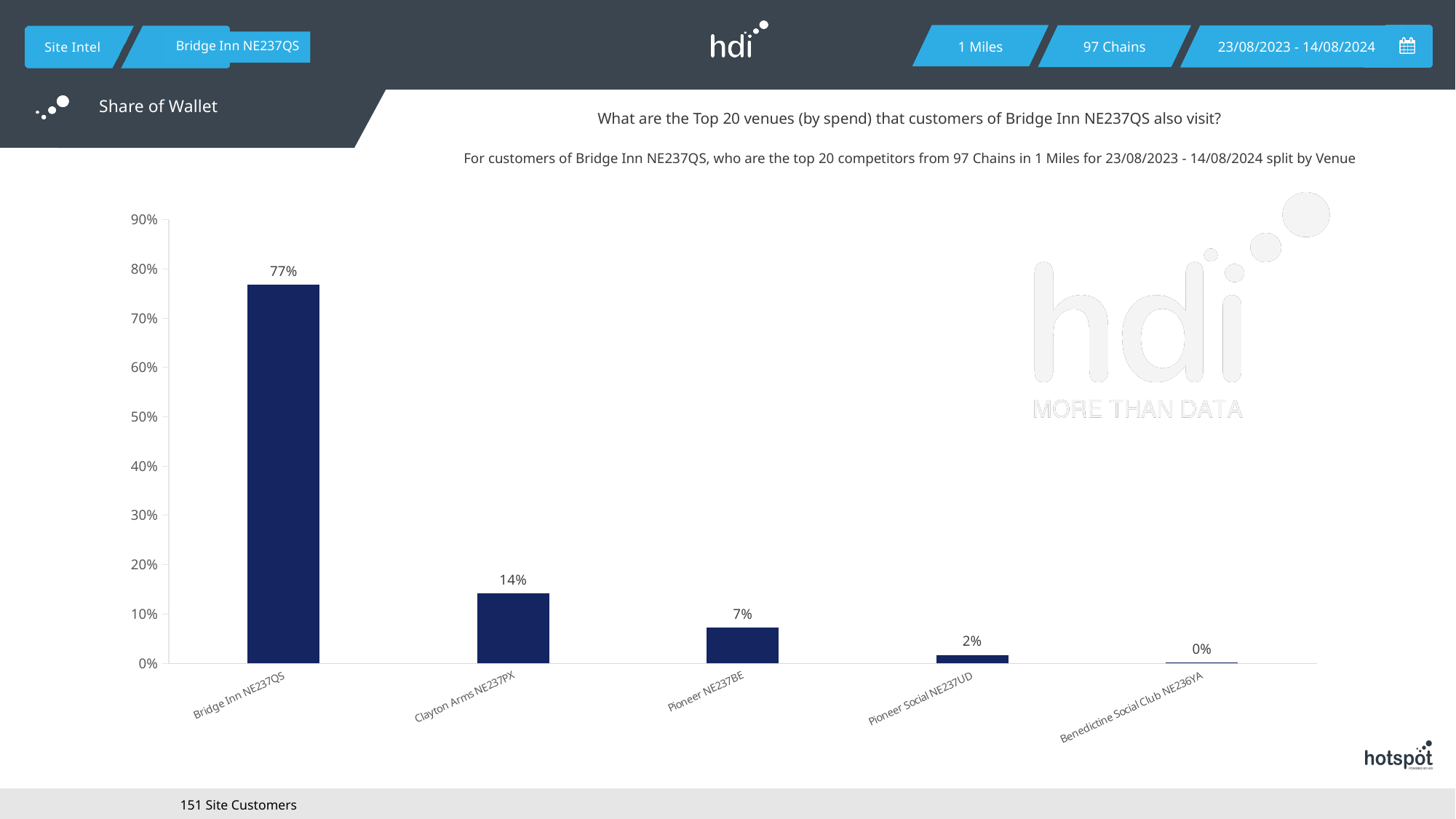
What is the value for Clayton Arms NE237PX? 14% Which venue has the highest value? Bridge Inn NE237QS What is the value for Pioneer Social NE237UD? 2% Which is larger, the value for Pioneer NE237BE or Pioneer Social NE237UD? Pioneer NE237BE What is the value for Pioneer NE237BE? 7% What kind of chart is shown? Bar chart What is the value for Bridge Inn NE237QS? 77% What is the difference between the values for Bridge Inn NE237QS and Clayton Arms NE237PX? 63% How many venues are shown on the chart? 5 What is the value for Benedictine Social Club NE236YA? 0% Which venue has the lowest value? Benedictine Social Club NE236YA Do the values rise or fall from left to right along the x axis? Fall